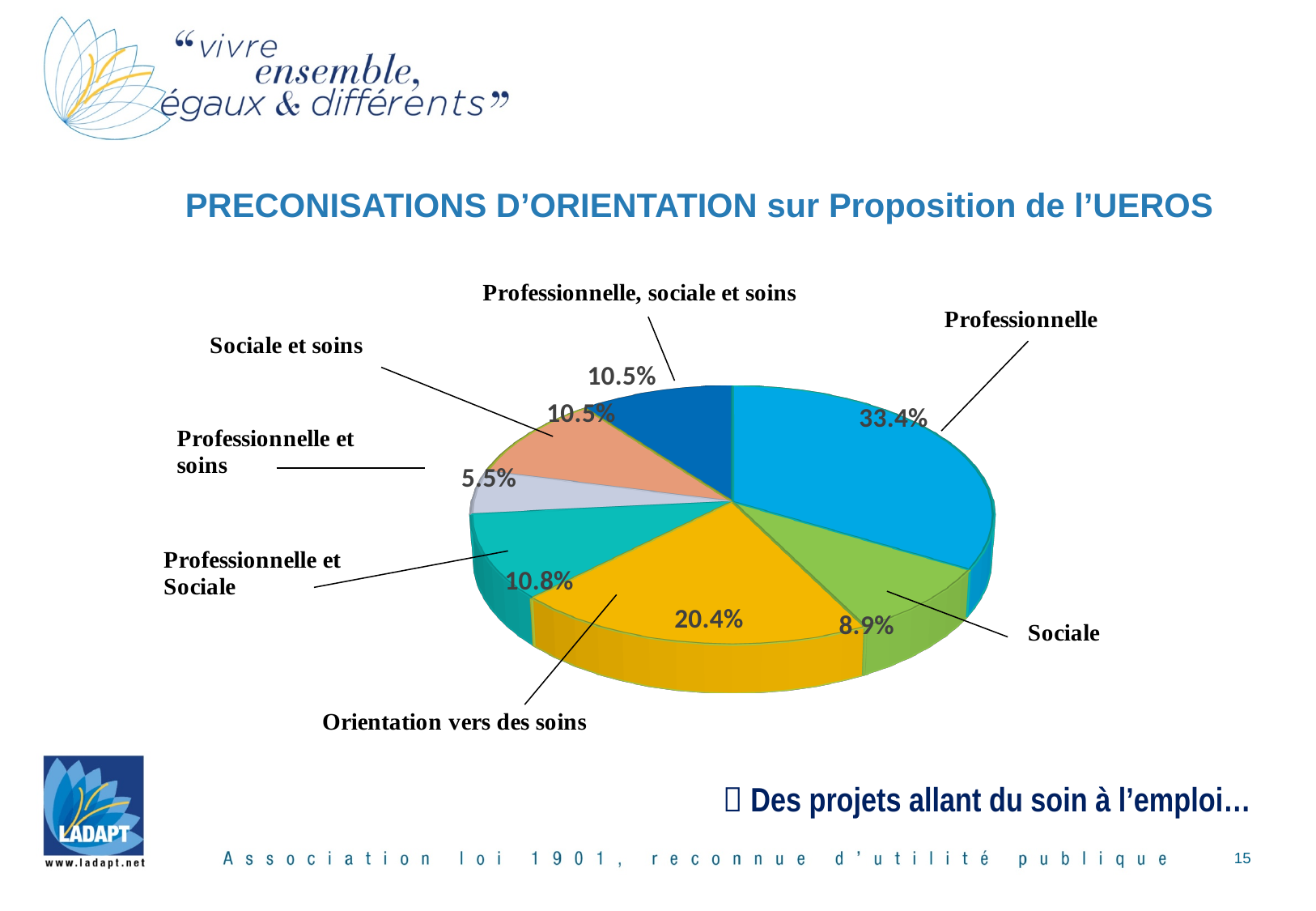
What percentage is shown for Professionnelle et Sociale? 10.8% What is the value for Professionnelle et soins? 5.5% What share of the pie does Professionnelle represent? 33.4% What is the value shown for Orientation vers des soins? 20.4% Which category has the largest slice of the pie? Professionnelle What is the difference in percentage points between Professionnelle and Orientation vers des soins? 13.0 Which is larger, the slice for Sociale or the slice for Professionnelle et Sociale? Professionnelle et Sociale What is the title of the chart on the slide? PRECONISATIONS D'ORIENTATION sur Proposition de l'UEROS How many categories are shown in the pie chart? 7 What percentage is shown for Sociale? 8.9% What type of chart is shown on the slide? Pie chart Which category has the smallest slice of the pie? Professionnelle et soins